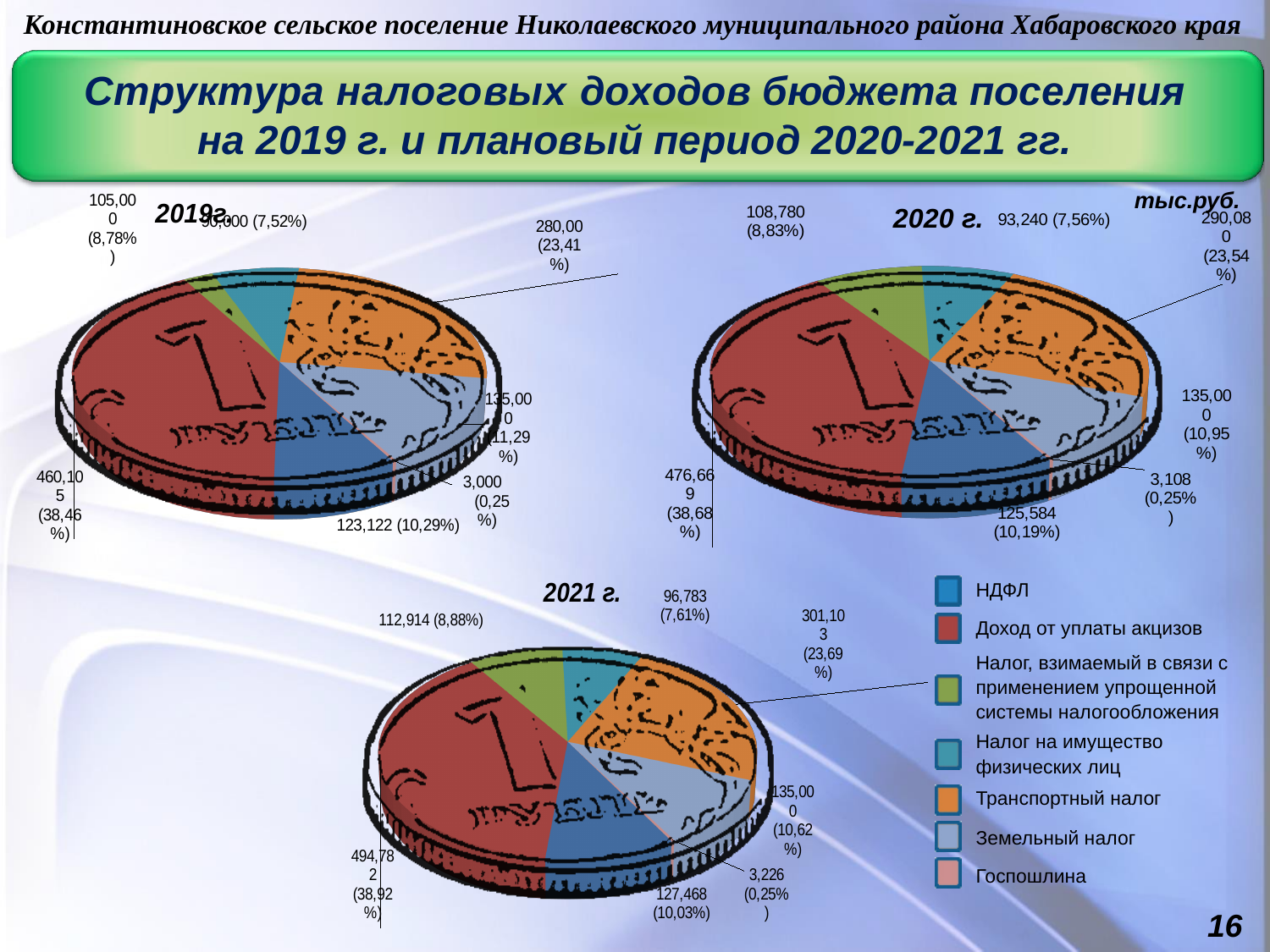
In the 2020 pie chart, what share corresponds to the value 290,080? 23,54% In the 2021 pie chart, what is the value of the largest slice? 494,782 How many entries does the legend list? 7 In the 2020 pie chart, what is the smallest value shown? 3,108 What kind of charts are shown on the slide? Pie charts In the 2019 pie chart, what is the value of the largest slice? 460,105 In what units are the values on the slide given? тыс.руб. In the 2021 pie chart, what share does the smallest slice have? 0,25% In the 2019 pie chart, what is the largest share shown? 38,46% How many pie charts are on the slide? 3 What is the difference between the largest slice in 2021 (494,782) and the largest slice in 2020 (476,669)? 18,113 Which is larger: the largest slice in the 2020 chart (476,669) or the largest slice in the 2021 chart (494,782)? 2021 (494,782)